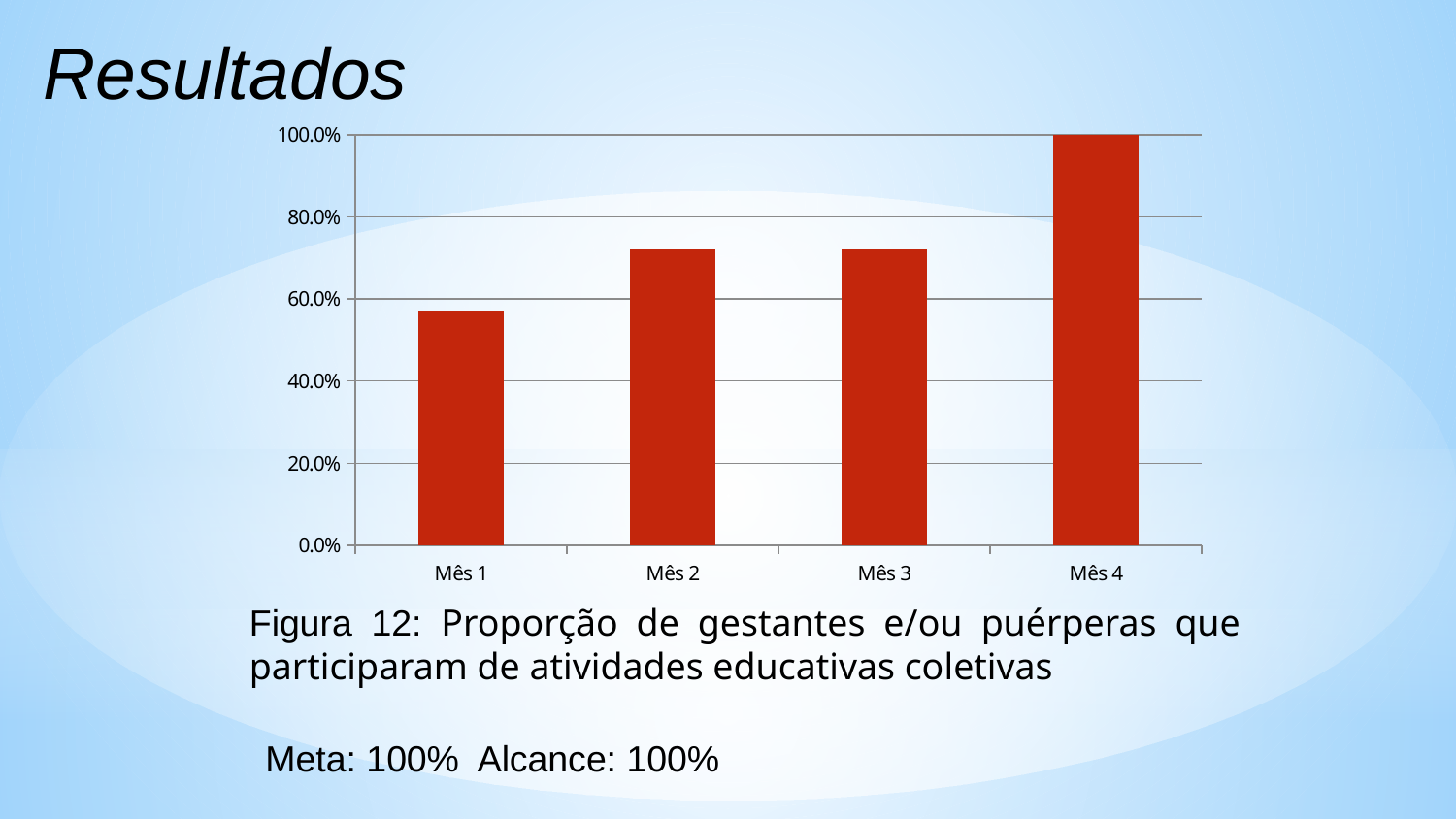
Is the value for Mês 1 greater or less than 40.0%? greater Is the value for Mês 3 greater or less than 80.0%? less How many months (categories) are shown on the x axis of the chart? 4 Do the values generally rise or fall from Mês 1 to Mês 4? rise Which month has the highest value in the chart? Mês 4 What kind of chart is shown on the slide? Bar chart What is the value for Mês 4 in the chart? 100.0% Which is larger, the value for Mês 1 or the value for Mês 2? Mês 2 Is the value for Mês 2 greater or less than 60.0%? greater Which month has the lowest value in the chart? Mês 1 What figure number is given in the caption below the chart? Figura 12